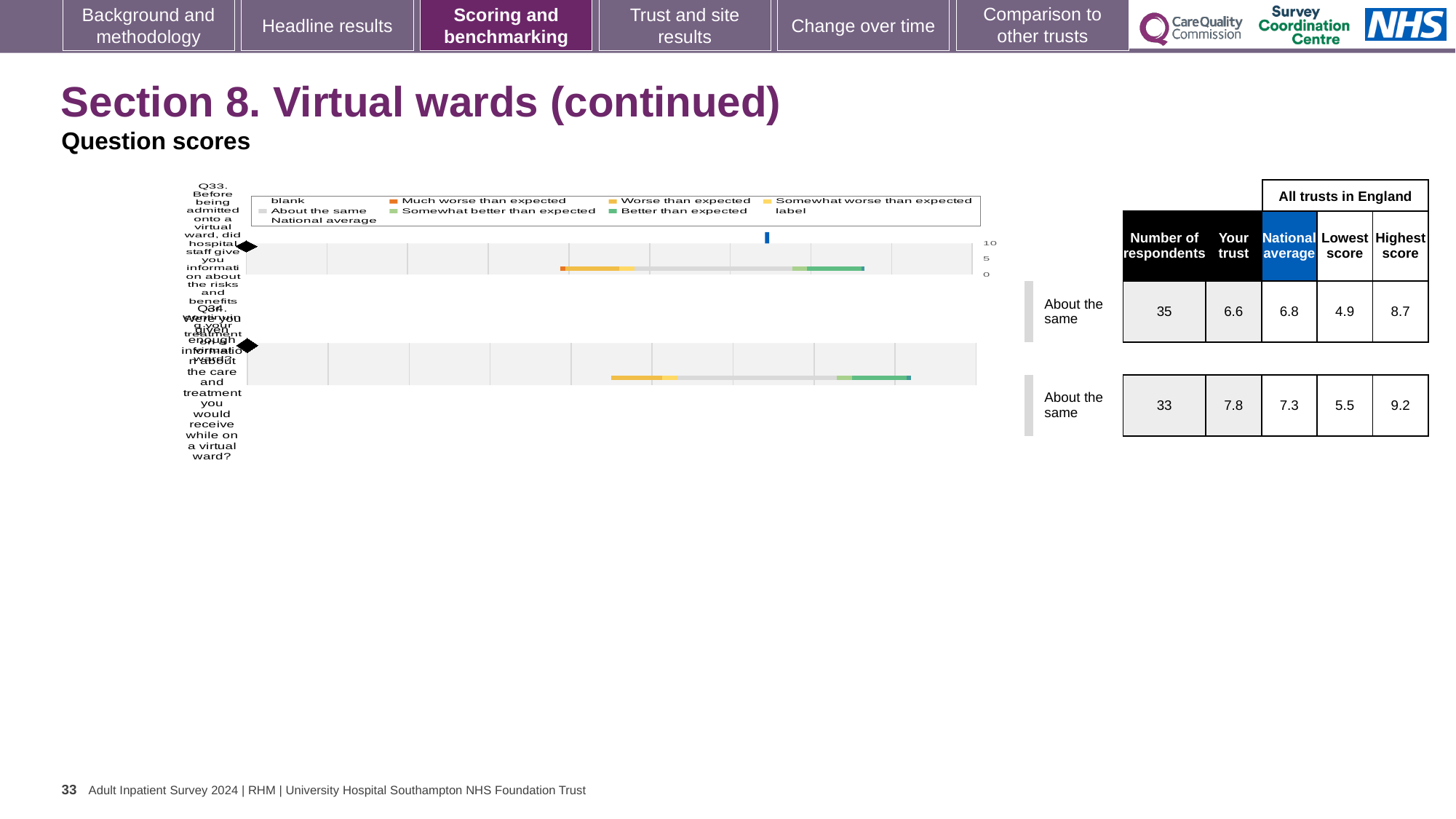
How many respondents answered Q33? 35 What is the 'Your trust' score for Q33? 6.6 What is the highest score among all trusts in England for Q34? 9.2 Which legend entry is shown in dark green? Better than expected How many entries does the chart legend list? 9 What is the national average score for Q33? 6.8 What is the difference between the 'Your trust' scores for Q34 and Q33? 1.2 Which question has the higher 'Your trust' score, Q33 or Q34? Q34 Which legend entry is shown in orange? Much worse than expected What is the 'Your trust' score for Q34? 7.8 How many questions (categories) are plotted in the chart? 2 What kind of chart is shown on the slide? bar chart